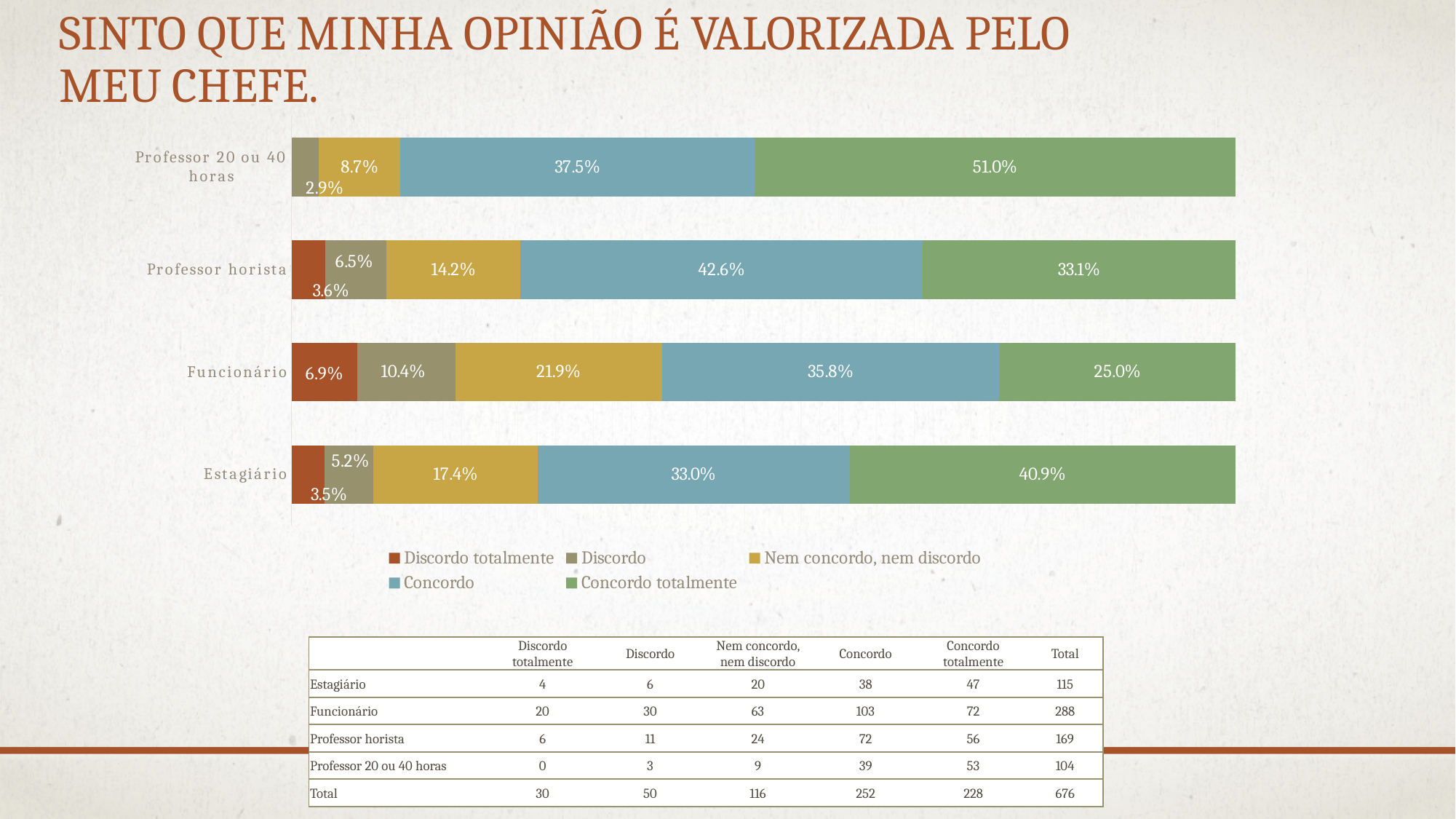
What is the value for "Concordo" for Professor horista? 42.6% What kind of chart is shown on the slide? Stacked bar chart Which category has the highest value for "Concordo totalmente"? Professor 20 ou 40 horas What is the value for "Concordo totalmente" for Professor 20 ou 40 horas? 51.0% How many categories are shown on the chart? 4 Which is larger: the "Discordo" value for Funcionário or for Professor horista? Funcionário What is the value for "Nem concordo, nem discordo" for Funcionário? 21.9% What is the value for "Discordo totalmente" for Estagiário? 3.5% Which category has the lowest value for "Concordo"? Estagiário How many series does the legend list? 5 Which colour represents "Concordo totalmente" in the legend? Green What is the difference between the "Concordo totalmente" values for Professor 20 ou 40 horas and Funcionário? 26.0%